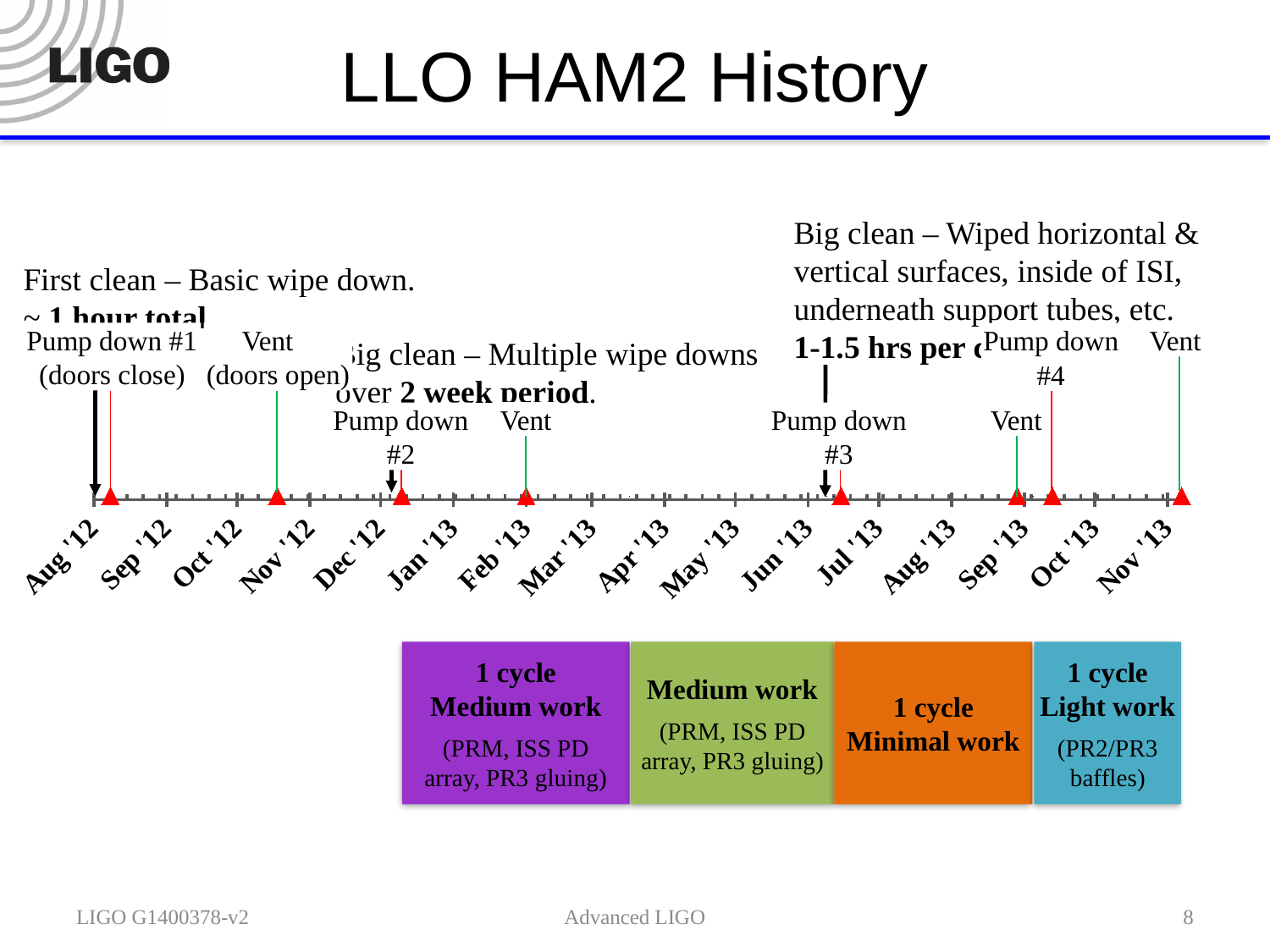
What is the latest month label on the timeline axis? Nov '13 What is the earliest month label on the timeline axis? Aug '12 What colour is the box labelled '1 cycle Light work'? Blue What kind of chart is shown on the slide? Timeline How many vent events are marked on the timeline? 4 What does the orange box below the timeline say? 1 cycle Minimal work Which work-cycle box mentions PR2/PR3 baffles? 1 cycle Light work What is the first event marked on the timeline? Pump down #1 (doors close) Which event immediately follows Pump down #2 on the timeline? Vent How many coloured work-cycle boxes are shown below the timeline? 4 How many pump down events are marked on the timeline? 4